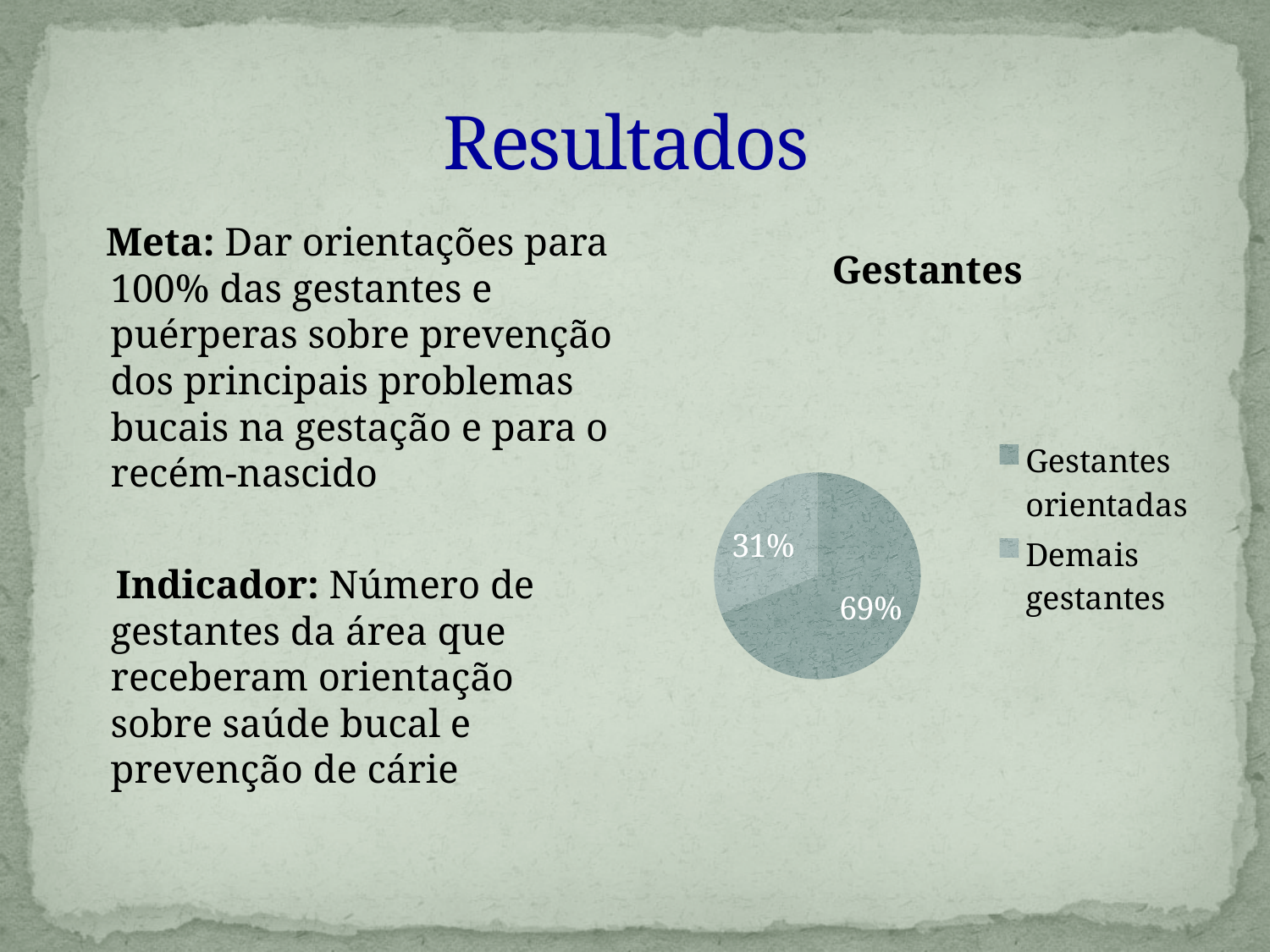
What are the two legend entries of the chart? Gestantes orientadas; Demais gestantes How many slices does the pie chart have? 2 Which is larger, the Gestantes orientadas slice or the Demais gestantes slice? Gestantes orientadas What share of the pie is labelled for Gestantes orientadas? 69% Which slice of the pie chart is the largest? Gestantes orientadas What share of the pie is labelled for Demais gestantes? 31% Which slice of the pie chart is the smallest? Demais gestantes What is the title of the chart? Gestantes What is the difference in percentage points between the Gestantes orientadas slice and the Demais gestantes slice? 38 How many entries does the chart legend list? 2 What kind of chart is shown on the slide? pie chart